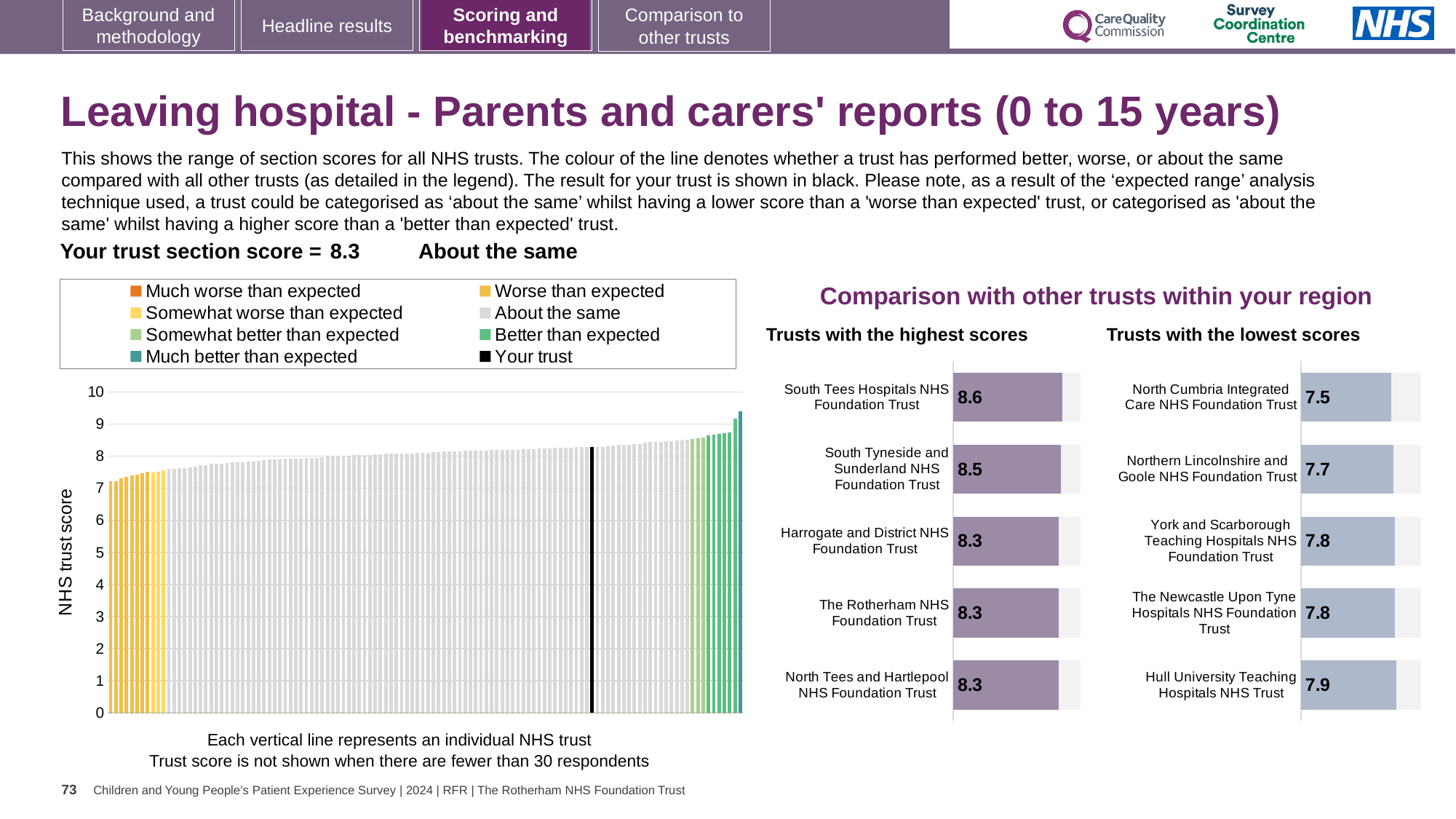
In the 'Trusts with the lowest scores' chart, which trust has the lowest score? North Cumbria Integrated Care NHS Foundation Trust Which has the larger score: South Tees Hospitals NHS Foundation Trust in the 'highest scores' chart or Hull University Teaching Hospitals NHS Trust in the 'lowest scores' chart? South Tees Hospitals NHS Foundation Trust What kind of chart is the main chart on the left showing NHS trust scores? Bar chart How many entries does the legend of the main 'NHS trust score' chart on the left list? 8 In the main 'NHS trust score' chart on the left, do the bar values rise or fall from left to right? Rise In the 'Trusts with the highest scores' chart, which trust has the highest score? South Tees Hospitals NHS Foundation Trust In the 'Trusts with the highest scores' chart, what is the difference between the scores of South Tees Hospitals NHS Foundation Trust and South Tyneside and Sunderland NHS Foundation Trust? 0.1 In the 'Trusts with the lowest scores' chart, what is the difference between the scores of Hull University Teaching Hospitals NHS Trust and North Cumbria Integrated Care NHS Foundation Trust? 0.4 In the 'Trusts with the lowest scores' chart, what is the score for North Cumbria Integrated Care NHS Foundation Trust? 7.5 How many trusts are listed in the 'Trusts with the lowest scores' chart? 5 In the main 'NHS trust score' chart on the left, is the value of the tallest bar greater or less than 9? greater In the 'Trusts with the highest scores' chart, what is the score for South Tees Hospitals NHS Foundation Trust? 8.6